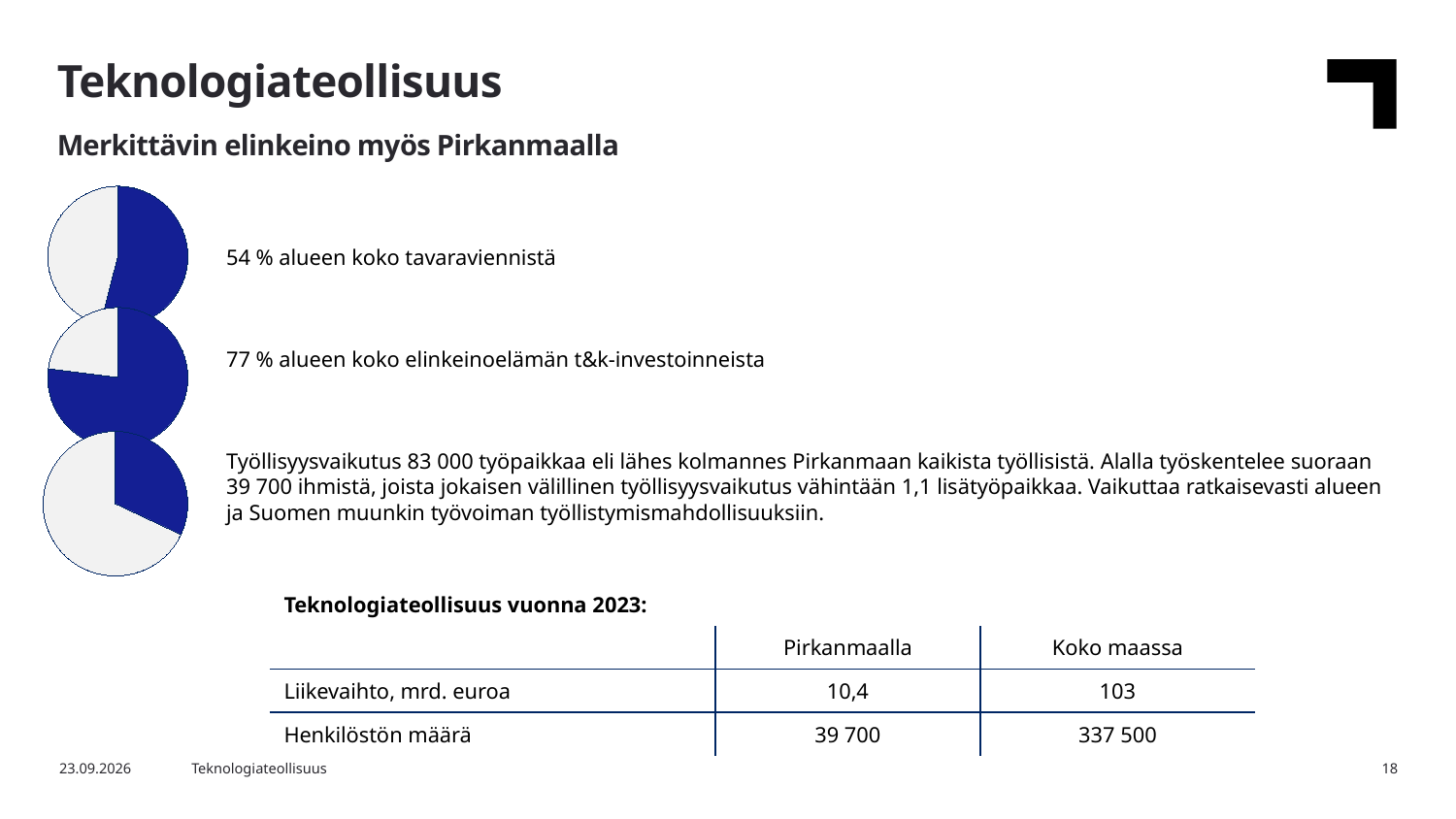
Which of the three pie charts has the smallest blue slice? The bottom pie chart Which of the three pie charts has the largest blue slice? The middle pie chart (77 %) Which pie chart has a larger blue slice, the top one or the bottom one? The top one What does the bottom pie chart illustrate, according to the text next to it? Employment impact of 83 000 jobs, nearly a third of all employed people in Pirkanmaa In the top pie chart, what share of the region's total goods exports does the blue slice represent? 54 % In the middle pie chart, what share of the region's business R&D investments does the blue slice represent? 77 % How many pie charts are on the slide? 3 Is the blue slice in the middle pie chart greater or less than 50% of the pie? greater What kind of charts are shown on the left side of the slide? Pie charts What colour is used for the highlighted slice in each pie chart? Blue What is the difference in percentage points between the blue share in the middle pie chart and the blue share in the top pie chart? 23 percentage points Is the blue slice in the bottom pie chart greater or less than 50% of the pie? less